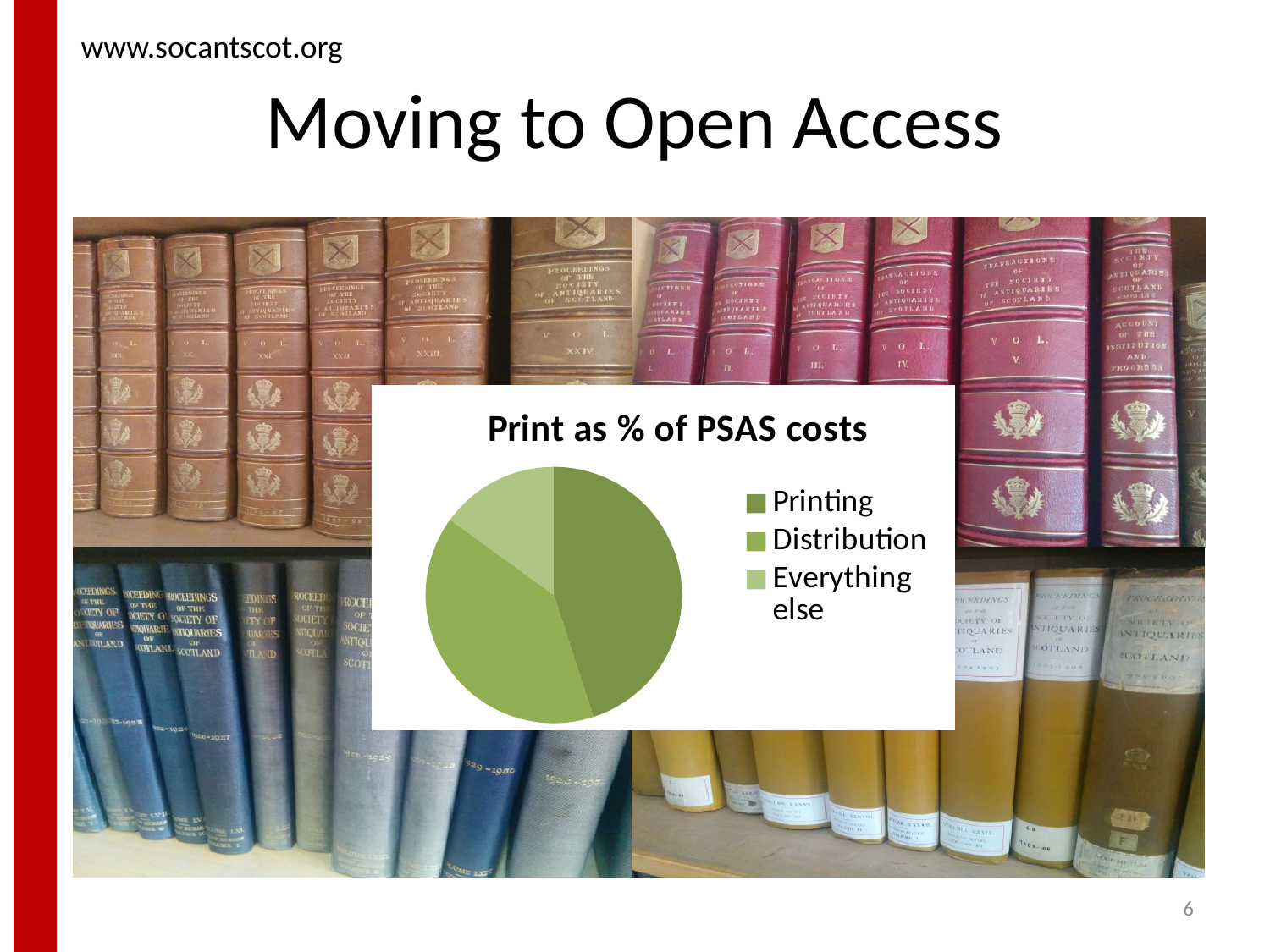
What kind of chart is shown on the slide? pie chart Which is larger, the slice for Printing or the slice for Distribution? Printing Which category has the largest slice of the pie? Printing Which legend entry is listed first? Printing How many slices does the pie chart have? 3 How many entries does the legend list? 3 Which is larger, the slice for Distribution or the slice for Everything else? Distribution Which category has the smallest slice of the pie? Everything else What is the title of the chart? Print as % of PSAS costs